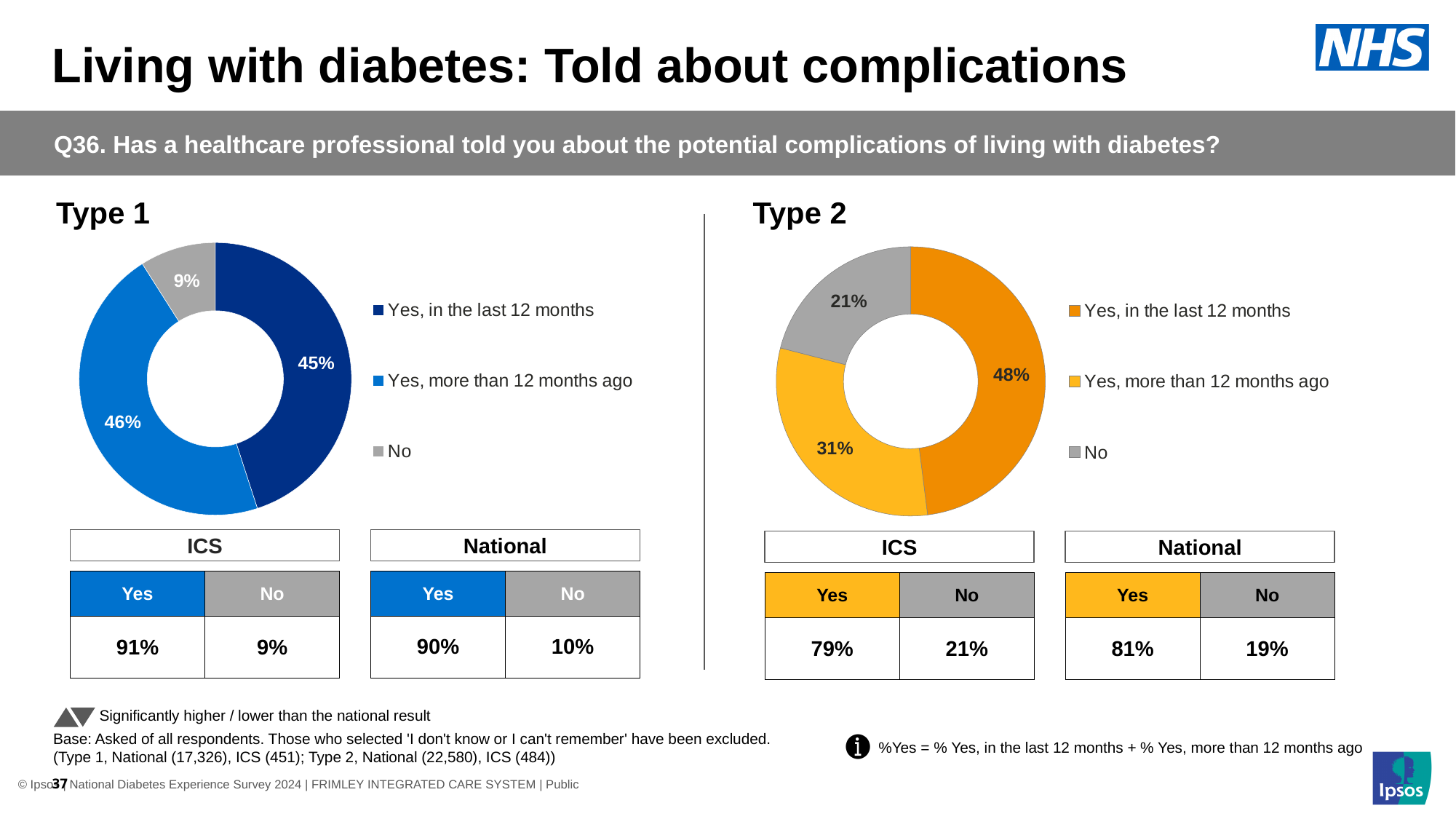
In the Type 2 chart, which category has the largest share? Yes, in the last 12 months What colour represents 'No' in the Type 1 chart? Grey In the Type 2 chart, what is the difference between 'Yes, in the last 12 months' and 'Yes, more than 12 months ago'? 17 percentage points In the Type 2 chart, what is the combined share of the two 'Yes' categories? 79% How many categories does the Type 1 chart show? 3 What type of chart is used for Type 2? Doughnut chart In the Type 1 chart, what is the difference between the 'Yes, more than 12 months ago' share and the 'No' share? 37 percentage points In the Type 2 chart, what percentage of respondents said 'No'? 21% In the Type 1 chart, what percentage of respondents said 'Yes, in the last 12 months'? 45% In the Type 1 chart, what percentage of respondents said 'Yes, more than 12 months ago'? 46% Which is larger in the Type 2 chart: 'Yes, more than 12 months ago' or 'No'? Yes, more than 12 months ago In the Type 1 chart, which category has the smallest share? No